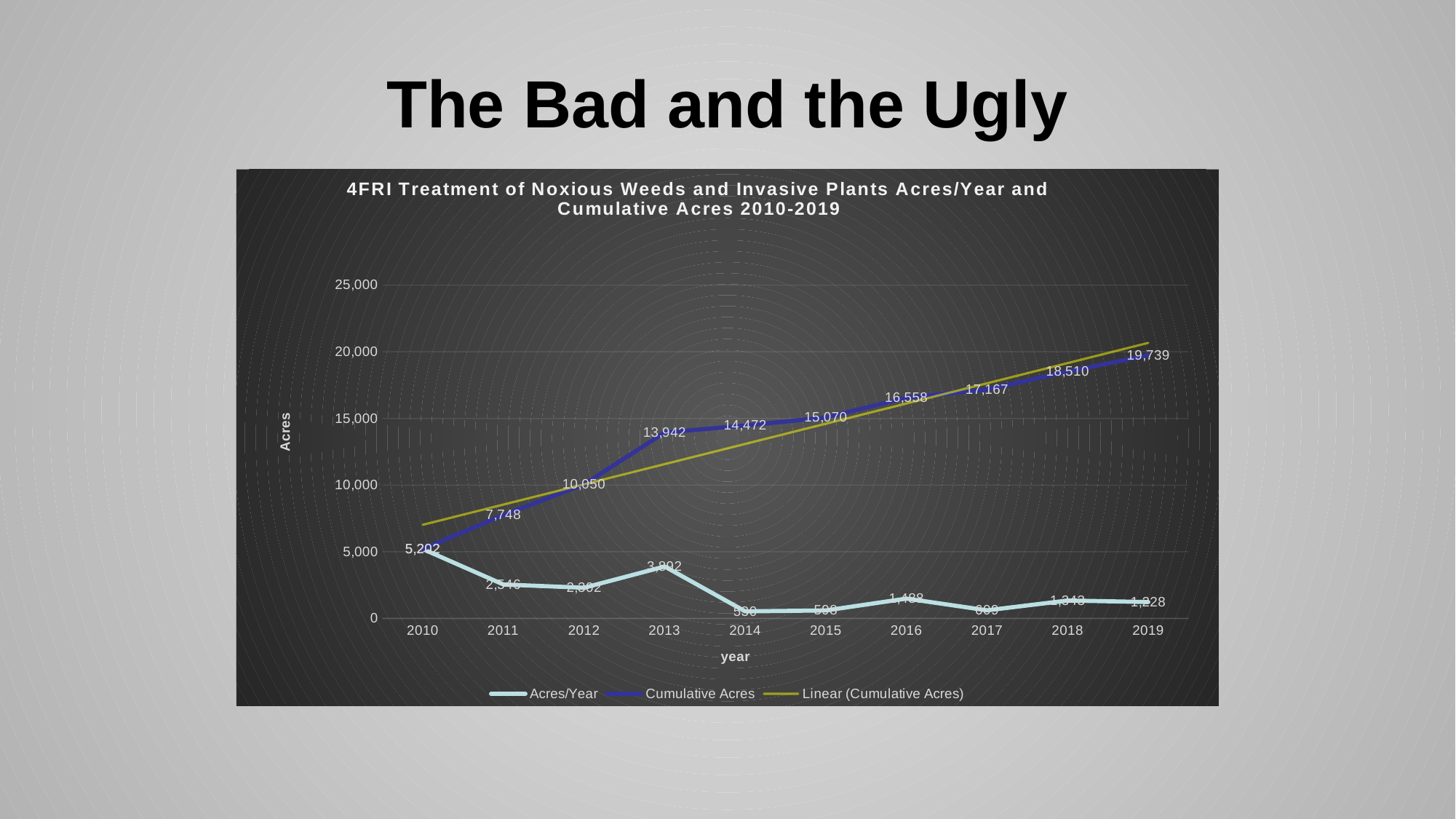
Is the Acres/Year value for 2014 greater or less than 5,000? less How many series does the legend list? 3 Which is larger, the Cumulative Acres value for 2016 or for 2015? 2016 In which year is the Cumulative Acres value lowest? 2010 How many years are shown on the x axis? 10 Does the Cumulative Acres series rise or fall from 2010 to 2019? rise What is the difference between the Cumulative Acres values for 2019 and 2018? 1,229 What is the Cumulative Acres value for 2013? 13,942 In which year is the Cumulative Acres value highest? 2019 What is the Cumulative Acres value for 2019? 19,739 What kind of chart is shown on the slide? line chart What is the Cumulative Acres value for 2012? 10,050